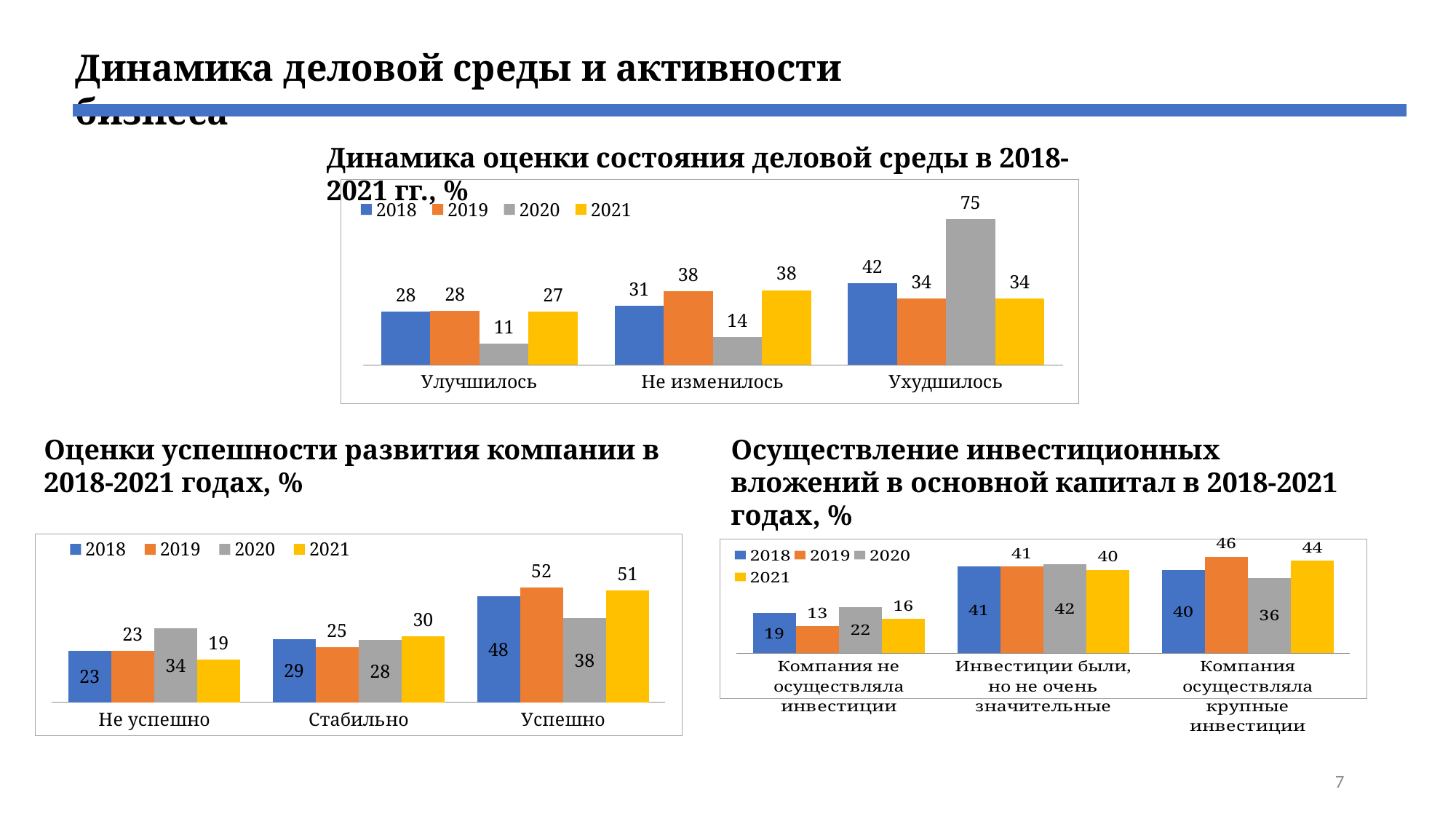
In the chart 'Оценки успешности развития компании в 2018-2021 годах, %', which year has the highest value in the 'Не успешно' category? 2020 In the chart 'Оценки успешности развития компании в 2018-2021 годах, %', what is the value for 2019 in the 'Успешно' category? 52 In the chart 'Динамика оценки состояния деловой среды в 2018-2021 гг., %', what is the value for 2020 in the 'Ухудшилось' category? 75 In the chart 'Динамика оценки состояния деловой среды в 2018-2021 гг., %', which year has the lowest value in the 'Улучшилось' category? 2020 What type of chart is 'Осуществление инвестиционных вложений в основной капитал в 2018-2021 годах, %'? Bar chart In the chart 'Осуществление инвестиционных вложений в основной капитал в 2018-2021 годах, %', which colour represents the 2020 series? Grey In the chart 'Динамика оценки состояния деловой среды в 2018-2021 гг., %', what is the difference between the 2020 and 2018 values for 'Ухудшилось'? 33 In the chart 'Осуществление инвестиционных вложений в основной капитал в 2018-2021 годах, %', what is the value for 2019 in the category 'Компания осуществляла крупные инвестиции'? 46 In the chart 'Осуществление инвестиционных вложений в основной капитал в 2018-2021 годах, %', what is the difference between the 2020 and 2019 values for 'Компания не осуществляла инвестиции'? 9 In the chart 'Оценки успешности развития компании в 2018-2021 годах, %', which is larger for 'Стабильно': the 2021 value or the 2019 value? 2021 How many categories are shown on the x axis of the chart 'Оценки успешности развития компании в 2018-2021 годах, %'? 3 How many series does the legend list in the chart 'Динамика оценки состояния деловой среды в 2018-2021 гг., %'? 4